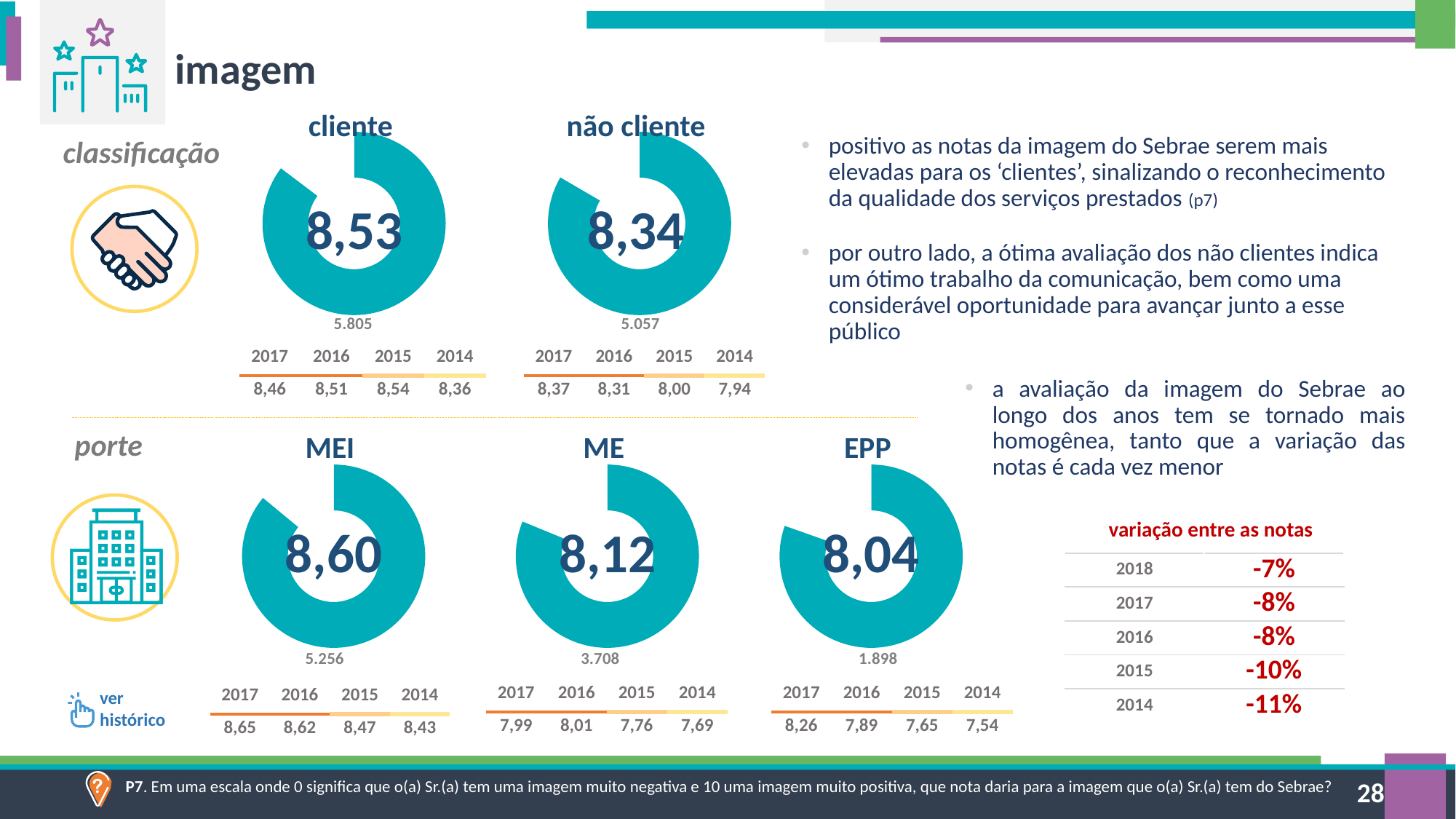
Which has the larger central value, the 'ME' donut chart or the 'EPP' donut chart? ME How many donut charts are shown on the slide? 5 What is the difference between the central values of the 'cliente' and 'não cliente' donut charts? 0,19 In the historical row below the 'MEI' donut chart, what was the value for 2014? 8,43 What kind of chart is used to display the 'cliente' score of 8,53? Donut chart Among the three 'porte' donut charts (MEI, ME, EPP), which has the lowest central value? EPP What value is shown in the centre of the 'MEI' donut chart? 8,60 What value is shown in the centre of the 'cliente' donut chart? 8,53 Among the three 'porte' donut charts (MEI, ME, EPP), which has the highest central value? MEI In the historical row below the 'não cliente' donut chart, do the values rise or fall from 2014 to 2017? Rise What value is shown in the centre of the 'não cliente' donut chart? 8,34 What value is shown in the centre of the 'EPP' donut chart? 8,04